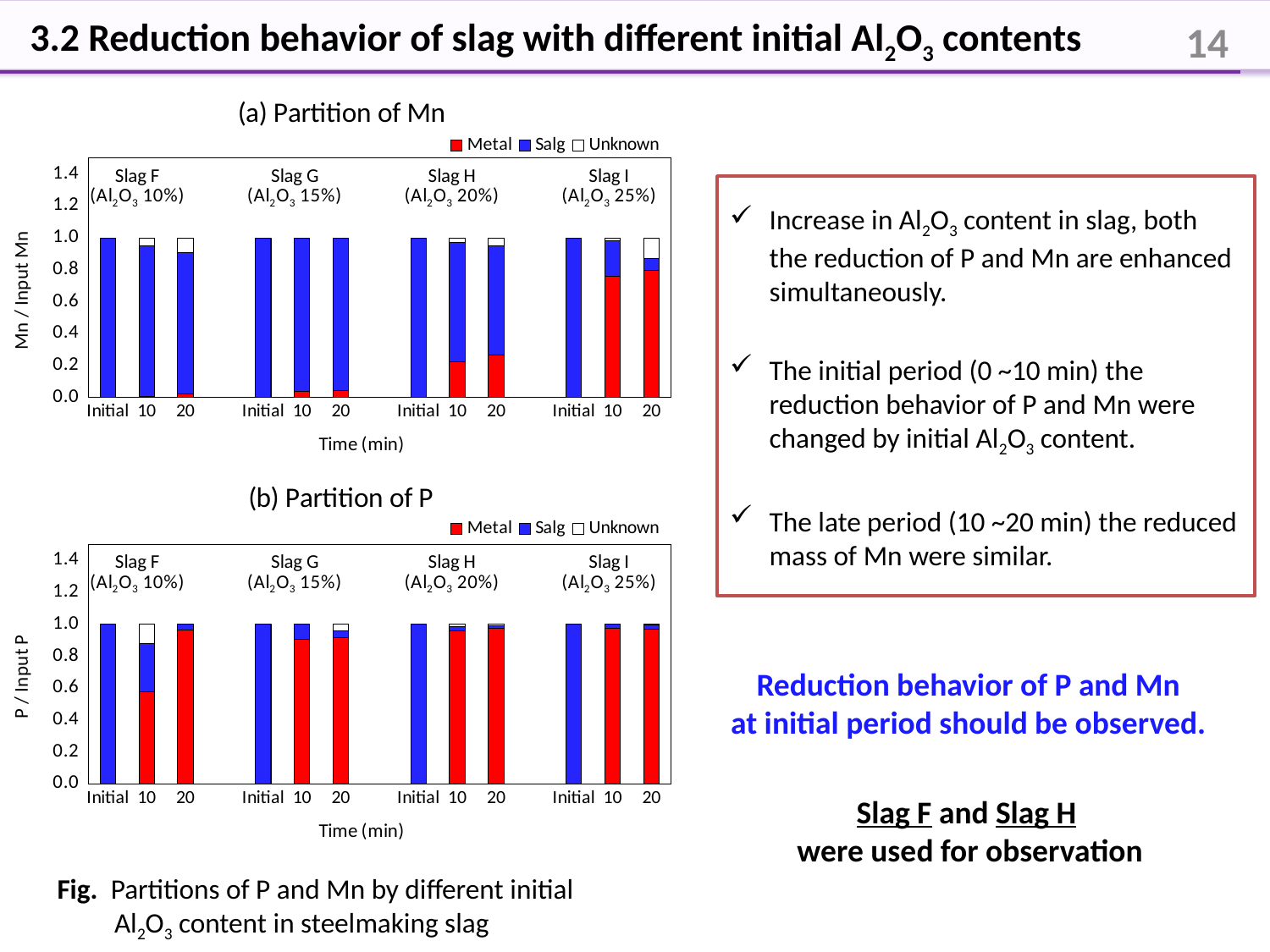
In '(b) Partition of P', which is larger at 10 min: the Metal value for Slag F or for Slag G? Slag G How many series does the legend of '(b) Partition of P' list? 3 In '(b) Partition of P', which slag has the lowest Metal value at 10 min? Slag F In '(a) Partition of Mn', which slag has the highest Metal value at 20 min? Slag I What kind of chart is used in '(a) Partition of Mn'? Stacked bar chart In '(b) Partition of P', is the Metal value for Slag F at 10 min greater or less than 0.4? greater What are the legend entries in '(a) Partition of Mn'? Metal, Salg, Unknown In '(a) Partition of Mn', does the Metal value for Slag I rise or fall from Initial to 20 min? rise How many slag groups are shown in '(b) Partition of P'? 4 In '(a) Partition of Mn', is the Metal value for Slag F at 20 min greater or less than 0.2? less How many bars are plotted in '(a) Partition of Mn'? 12 In '(a) Partition of Mn', is the Metal value for Slag I at 20 min greater or less than 0.6? greater